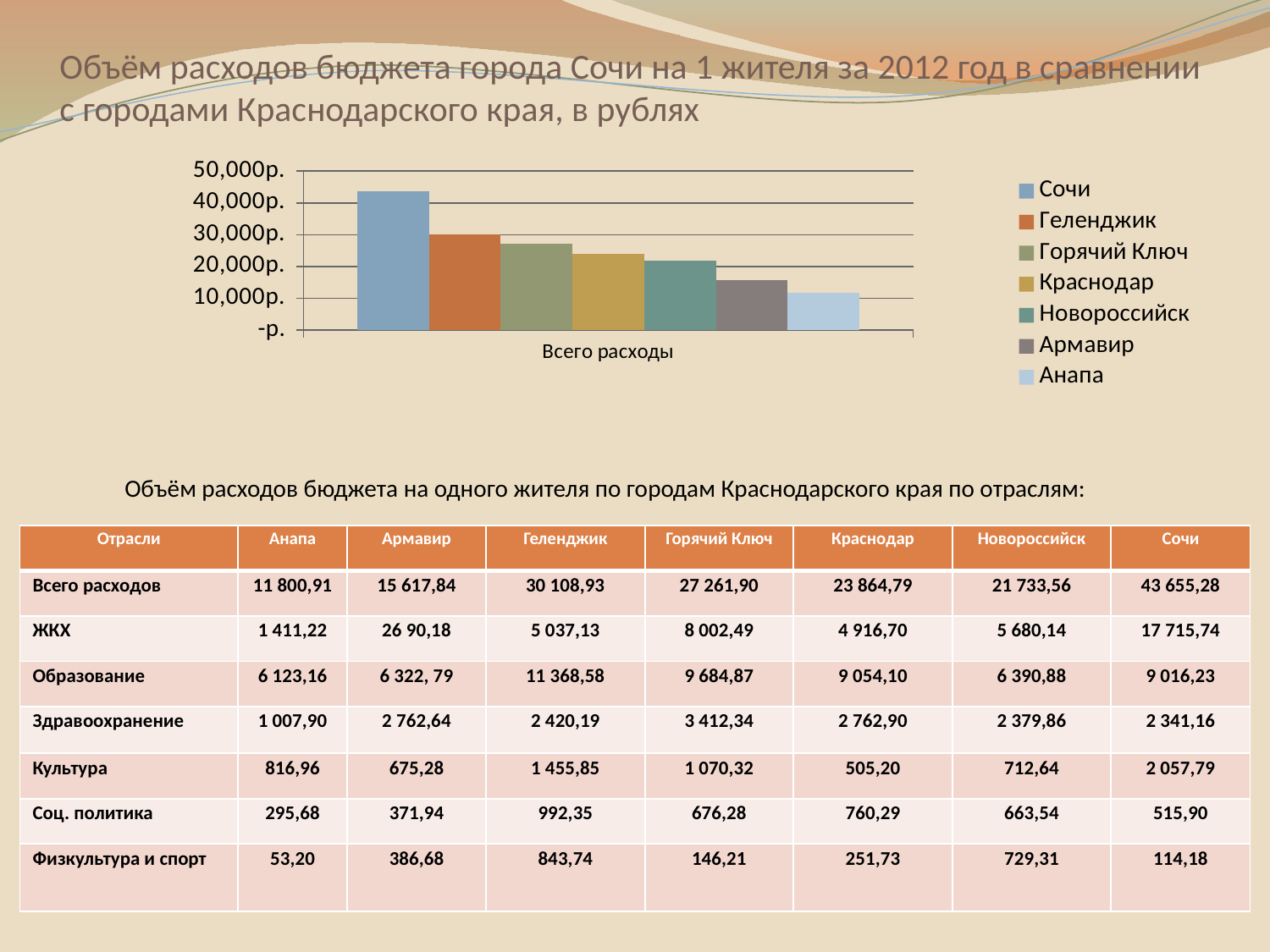
Is the value for Краснодар in the chart greater or less than 20,000р.? greater How many series does the chart legend list? 7 What is the category label shown on the x axis of the chart? Всего расходы Is the value for Горячий Ключ in the chart greater or less than 30,000р.? less What kind of chart is shown on the slide? bar chart Is the value for Армавир in the chart greater or less than 20,000р.? less Which city has the tallest bar in the chart? Сочи Which bar is taller in the chart, Геленджик or Новороссийск? Геленджик Which city has the shortest bar in the chart? Анапа How many categories are shown on the x axis of the chart? 1 Do the bars in the chart rise or fall from left to right? fall